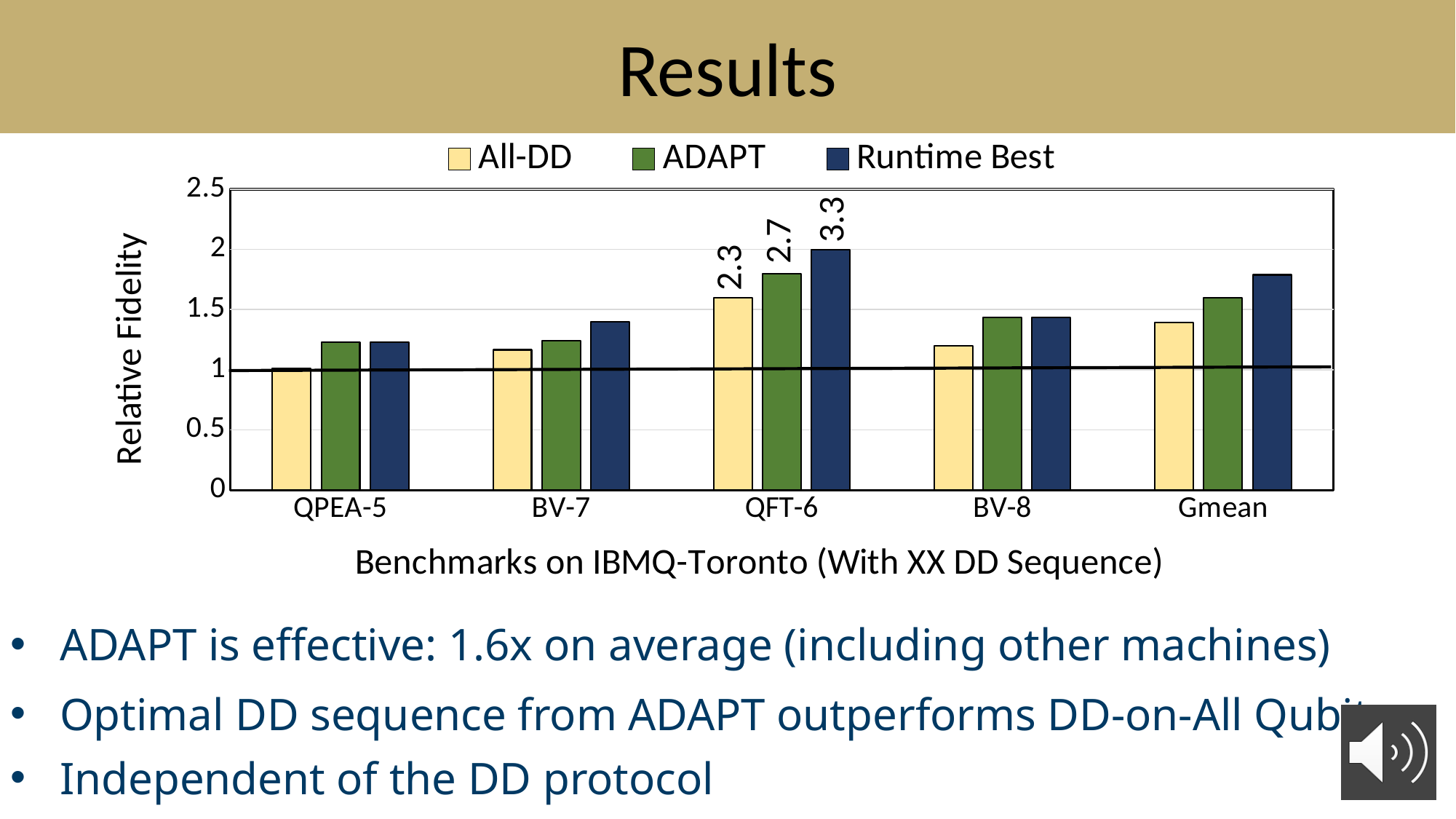
What is the ADAPT value for QFT-6? 2.7 For Gmean, which is larger: the ADAPT value or the All-DD value? ADAPT How many series does the legend list? 3 Which benchmark has the lowest All-DD value? QPEA-5 What is the All-DD value for QFT-6? 2.3 What is the Runtime Best value for QFT-6? 3.3 What is the label on the y axis? Relative Fidelity What is the difference between the Runtime Best and All-DD values for QFT-6? 1.0 Is the Runtime Best value for Gmean greater or less than 1.5? greater How many benchmark categories are shown on the x axis? 5 Which benchmark has the highest Runtime Best value? QFT-6 What kind of chart is shown on the slide? bar chart